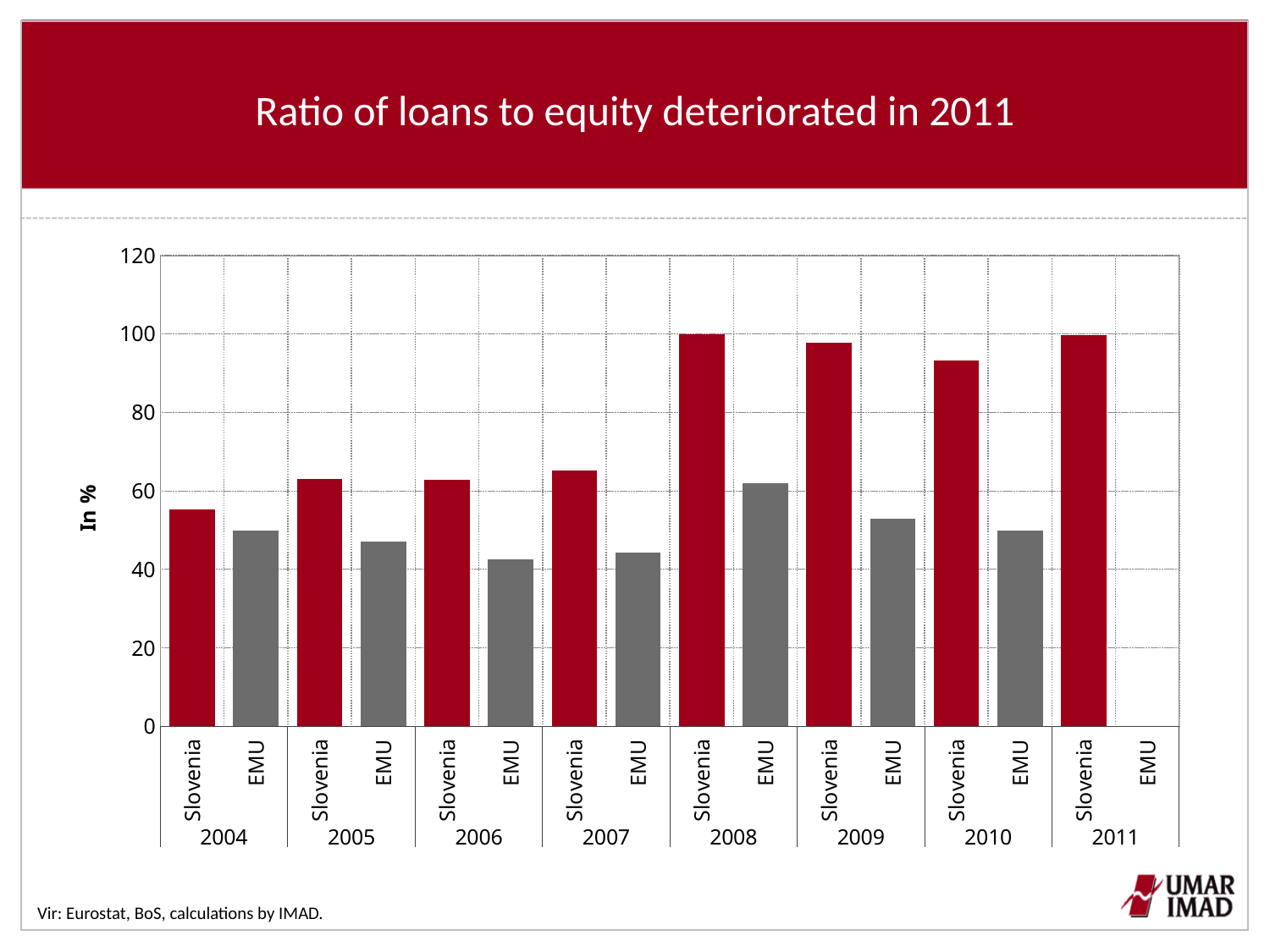
What is the label on the vertical axis of the chart? In % In which year is the Slovenia bar the lowest? 2004 Is the value for EMU in 2006 greater or less than 60? less Is the value for EMU in 2009 greater or less than 60? less Is the value for Slovenia in 2008 greater or less than 80? greater How many years are shown along the x axis of the chart? 8 What is the title of the slide's chart? Ratio of loans to equity deteriorated in 2011 Do the Slovenia values rise or fall from 2004 to 2008? Rise Which is larger, the value for Slovenia in 2011 or the value for Slovenia in 2010? Slovenia in 2011 In 2008, which is larger, the value for Slovenia or the value for EMU? Slovenia What kind of chart is shown on the slide? Bar chart